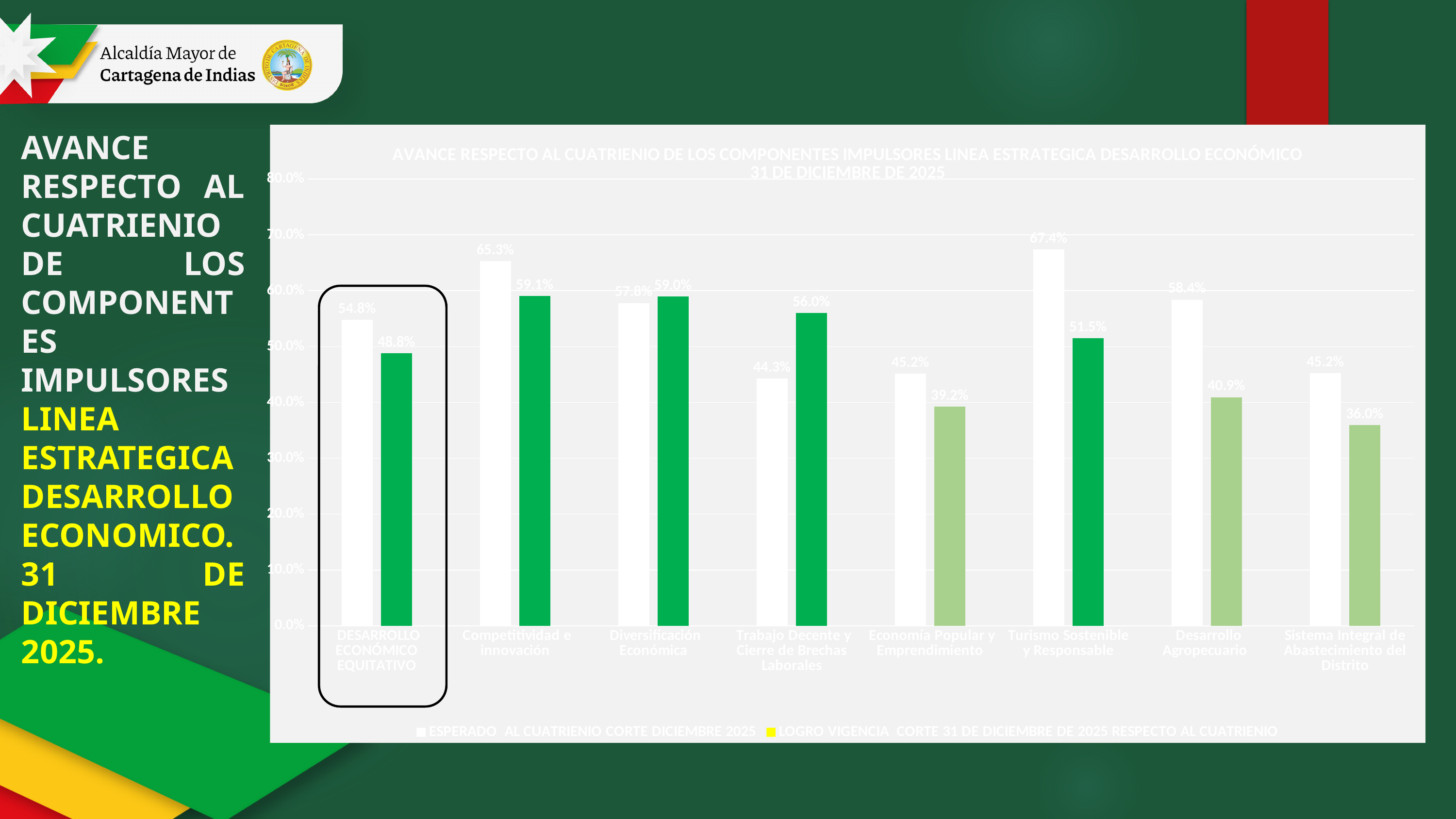
What is the LOGRO VIGENCIA value for DESARROLLO ECONÓMICO EQUITATIVO? 48.8% How many categories (components) are shown on the x axis of the chart? 8 For Trabajo Decente y Cierre de Brechas Laborales, which is larger: the ESPERADO value or the LOGRO value? LOGRO (56.0%) Which category has the lowest LOGRO VIGENCIA value? Sistema Integral de Abastecimiento del Distrito Which category has the highest ESPERADO AL CUATRIENIO value? Turismo Sostenible y Responsable What type of chart is shown on the slide? bar chart How many series does the chart's legend list? 2 What is the LOGRO VIGENCIA value for Sistema Integral de Abastecimiento del Distrito? 36.0% What colour are the bars for the ESPERADO AL CUATRIENIO series? white What is the difference between the ESPERADO and LOGRO values for Desarrollo Agropecuario? 17.5% Is the LOGRO VIGENCIA value for Economía Popular y Emprendimiento greater or less than 40.0%? less What is the ESPERADO AL CUATRIENIO value for Turismo Sostenible y Responsable? 67.4%